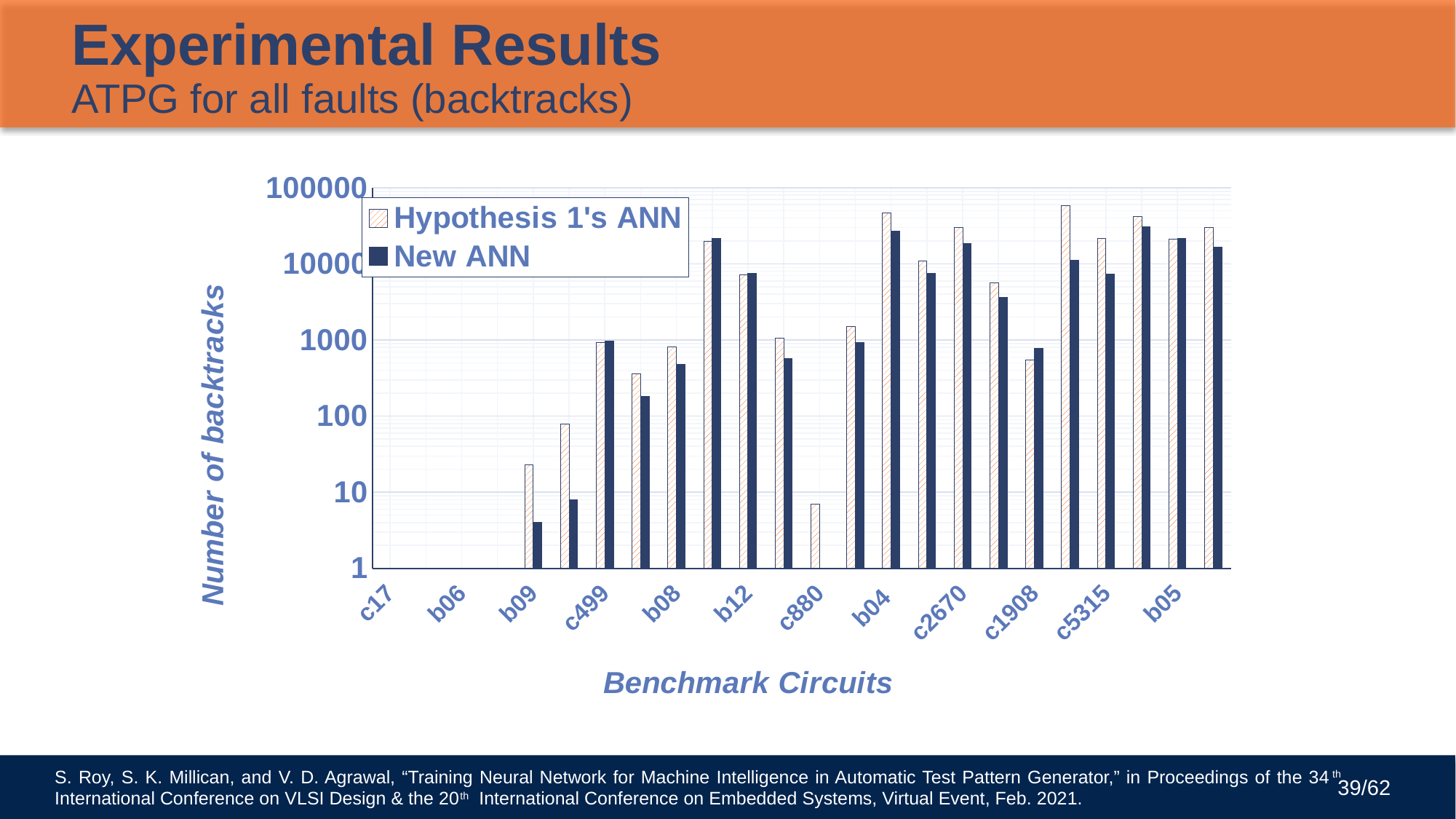
For c5315, which series has the larger value, Hypothesis 1's ANN or New ANN? Hypothesis 1's ANN How many series does the chart's legend list? 2 For b04, which series has the larger value, Hypothesis 1's ANN or New ANN? Hypothesis 1's ANN What kind of chart is shown on the slide? bar chart Is the Hypothesis 1's ANN value for b04 greater or less than 10000? greater What is the title of the chart's vertical axis? Number of backtracks Is the Hypothesis 1's ANN value for c880 greater or less than 10? less What is the title of the chart's horizontal axis? Benchmark Circuits Is the New ANN value for b09 greater or less than 10? less